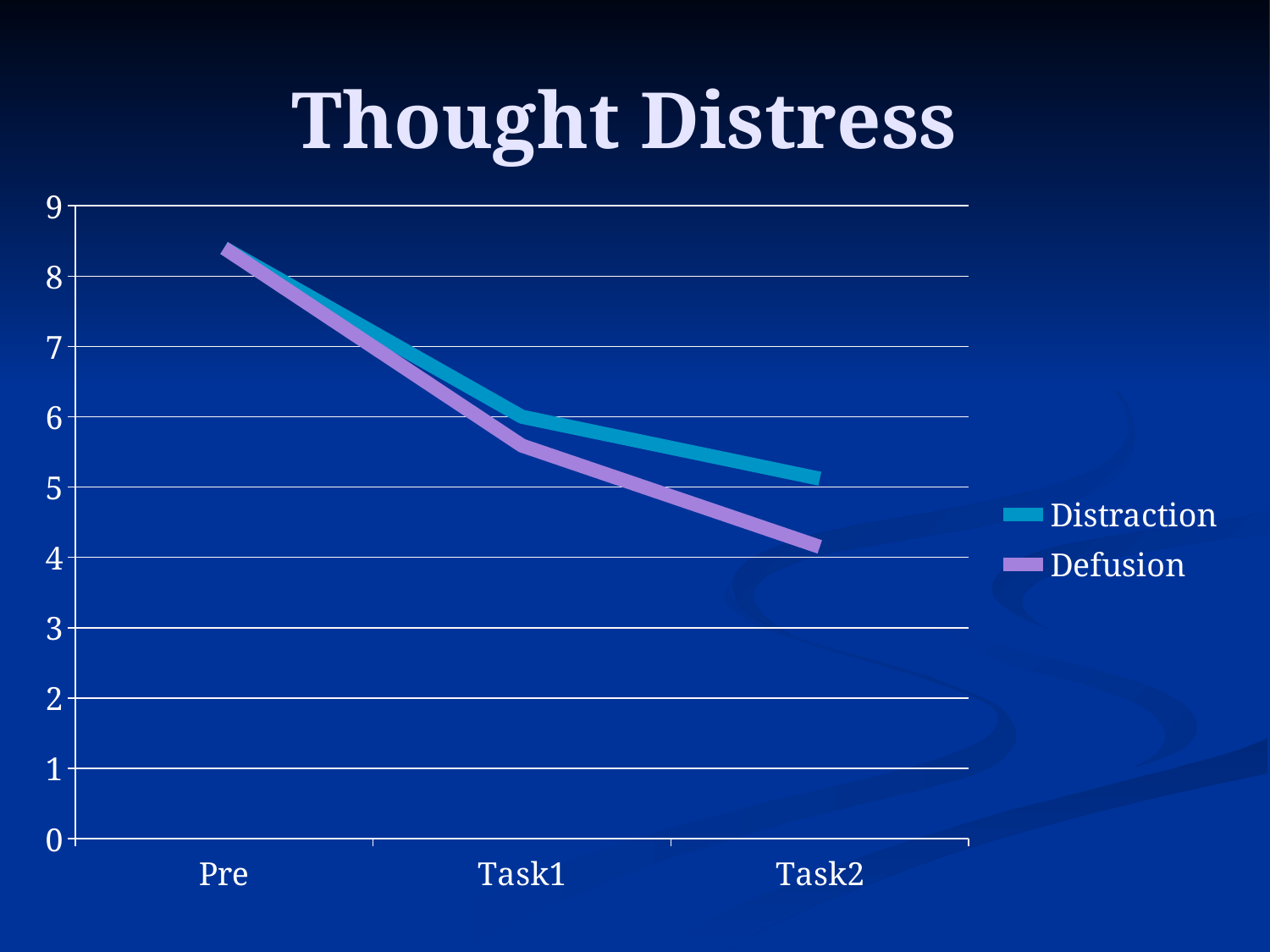
Which series is drawn in purple? Defusion What kind of chart is shown on the slide? line chart Is the value for Distraction at Task2 greater or less than 6? less Do the values for Defusion rise or fall from Pre to Task2? fall What is the title of the chart? Thought Distress Is the value for Defusion at Pre greater or less than 8? greater Do the values for Distraction rise or fall from Pre to Task2? fall How many series does the legend list? 2 How many categories are shown on the x axis? 3 At Task2, which series has the higher value, Distraction or Defusion? Distraction At Task1, which series has the higher value, Distraction or Defusion? Distraction Is the value for Defusion at Task2 greater or less than 5? less